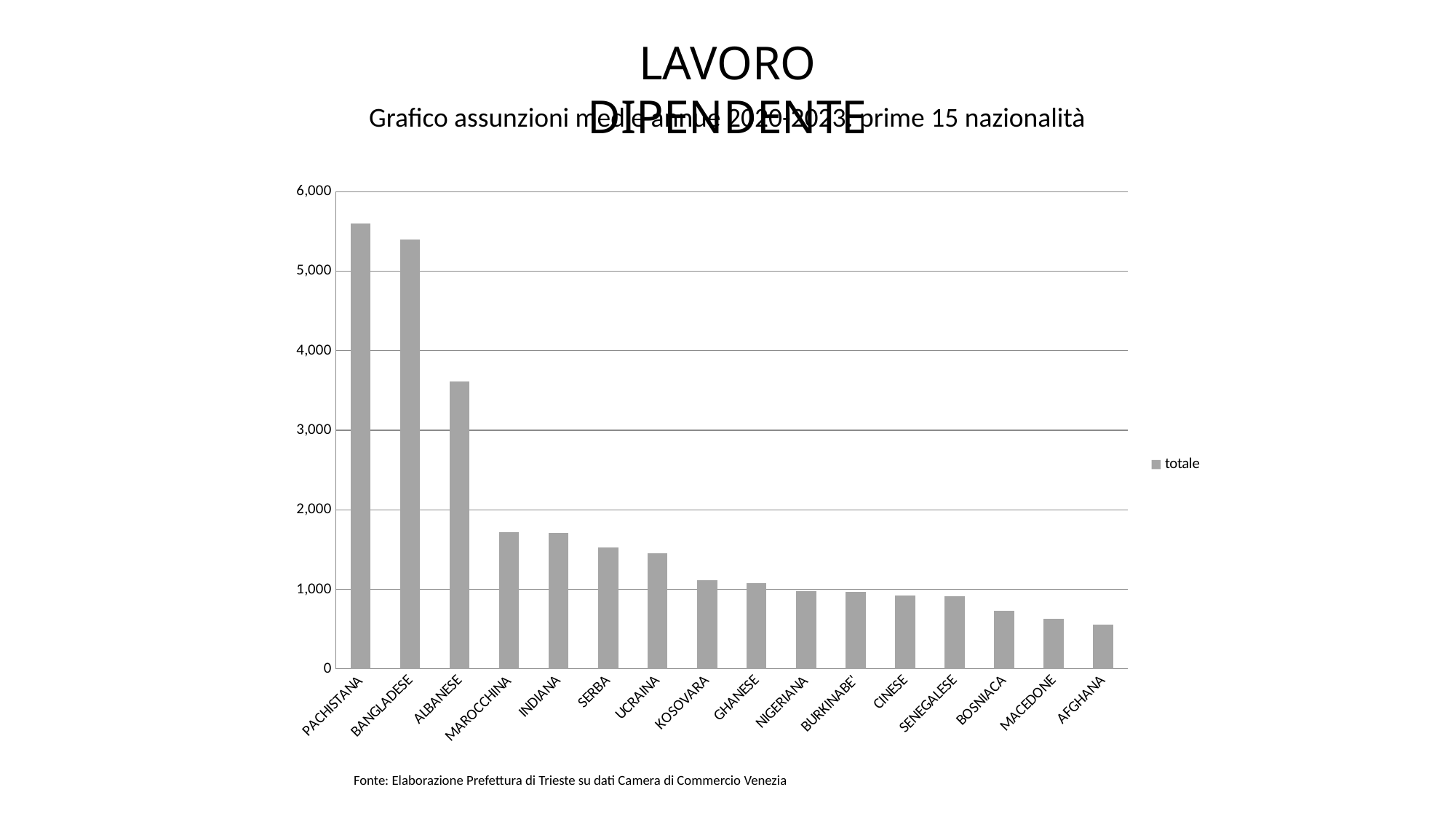
Which is larger, the value for ALBANESE or the value for MAROCCHINA? ALBANESE Which nationality has the lowest bar in the chart? AFGHANA What kind of chart is shown on the slide? bar chart Is the value for BOSNIACA greater or less than 1,000? less Do the values rise or fall moving from left to right along the x axis? fall How many nationalities (bars) are plotted in the chart? 16 Which nationality has the highest bar in the chart? PACHISTANA How many series does the legend list? 1 Is the value for SERBA greater or less than 1,000? greater Is the value for ALBANESE greater or less than 3,000? greater What is the name of the series shown in the legend? totale